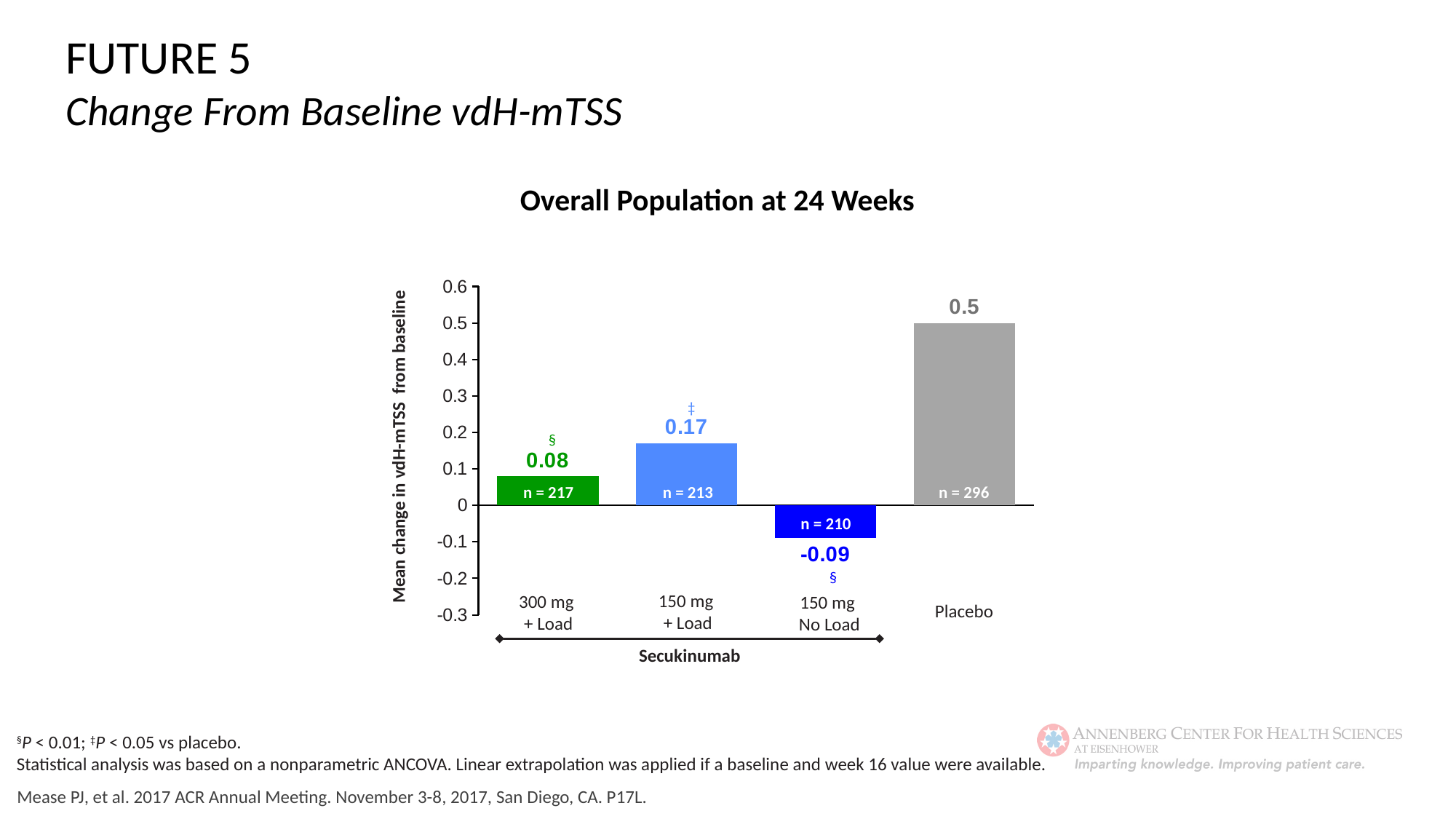
What is the title of the chart? Overall Population at 24 Weeks How many groups are shown in the chart? 4 What is the mean change in vdH-mTSS from baseline for the 150 mg No Load group? -0.09 What is the mean change in vdH-mTSS from baseline for the Placebo group? 0.5 Which group has the highest mean change in vdH-mTSS from baseline? Placebo Which group has the lowest mean change in vdH-mTSS from baseline? 150 mg No Load What is the mean change in vdH-mTSS from baseline for the 300 mg + Load group? 0.08 Which is larger, the value for 300 mg + Load or the value for 150 mg + Load? 150 mg + Load What is the mean change in vdH-mTSS from baseline for the 150 mg + Load group? 0.17 What is the sample size (n) for the Placebo group? n = 296 What is the difference between the Placebo value and the 150 mg + Load value? 0.33 What kind of chart is shown on the slide? Bar chart